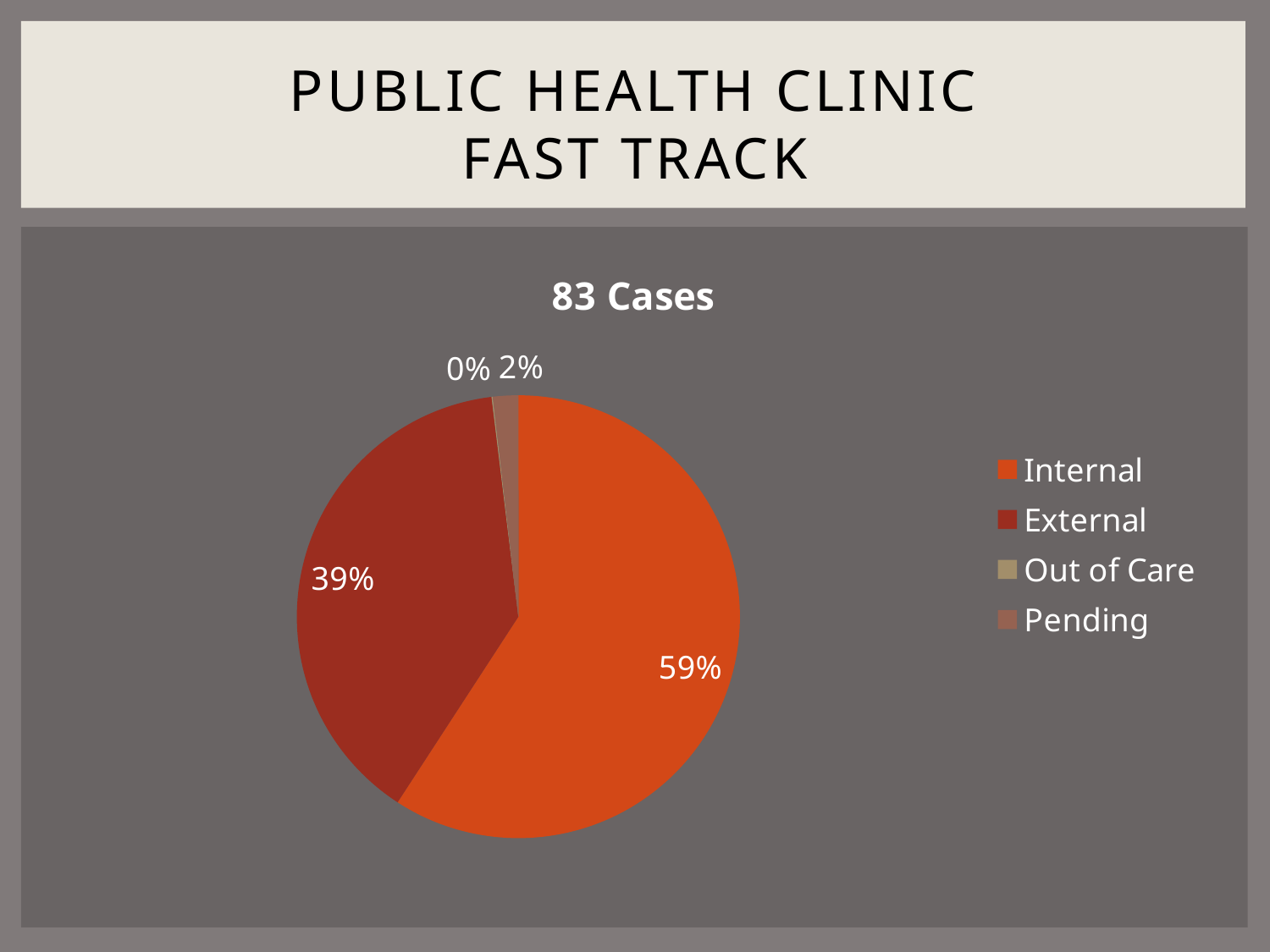
Which category has the largest slice of the pie? Internal What share of the pie does Out of Care represent? 0% How many categories does the legend list? 4 What share of the pie does Pending represent? 2% What is the difference in percentage points between the Internal and External slices? 20 What share of the pie does Internal represent? 59% What kind of chart is shown on the slide? pie chart Is the share for Internal greater or less than 50%? greater Which is larger, the External slice or the Pending slice? External Which category has the smallest slice of the pie? Out of Care What is the title of the chart? 83 Cases